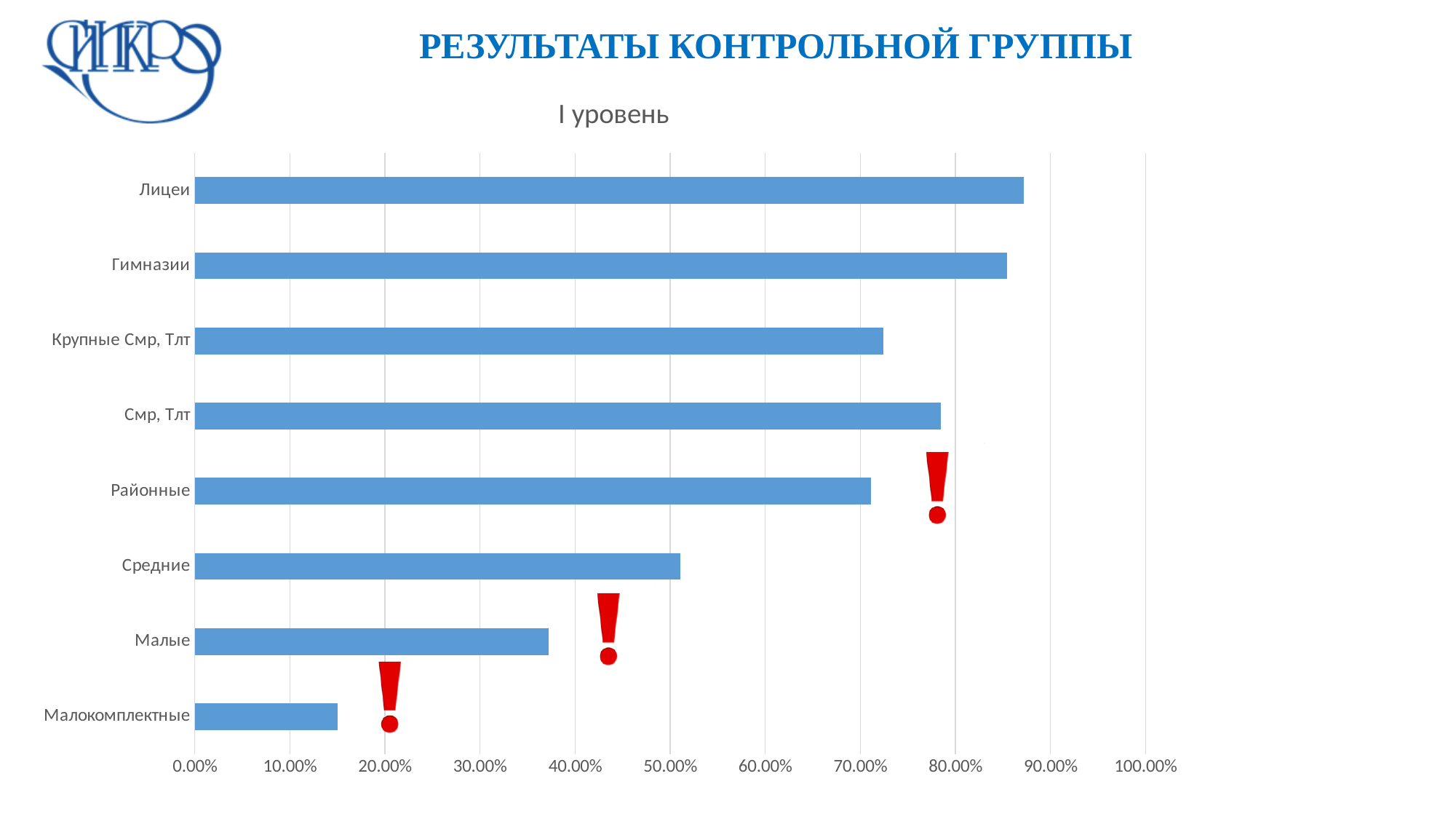
Is the value for Средние greater or less than 40.00%? greater Is the value for Малые greater or less than 40.00%? less Which category has the lowest value? Малокомплектные Which has the larger value, Смр, Тлт or Крупные Смр, Тлт? Смр, Тлт Is the value for Лицеи greater or less than 80.00%? greater Which category has the highest value? Лицеи How many categories are plotted in the chart? 8 What kind of chart is shown on the slide? bar chart Which has the larger value, Средние or Малые? Средние What is the title of the chart? I уровень